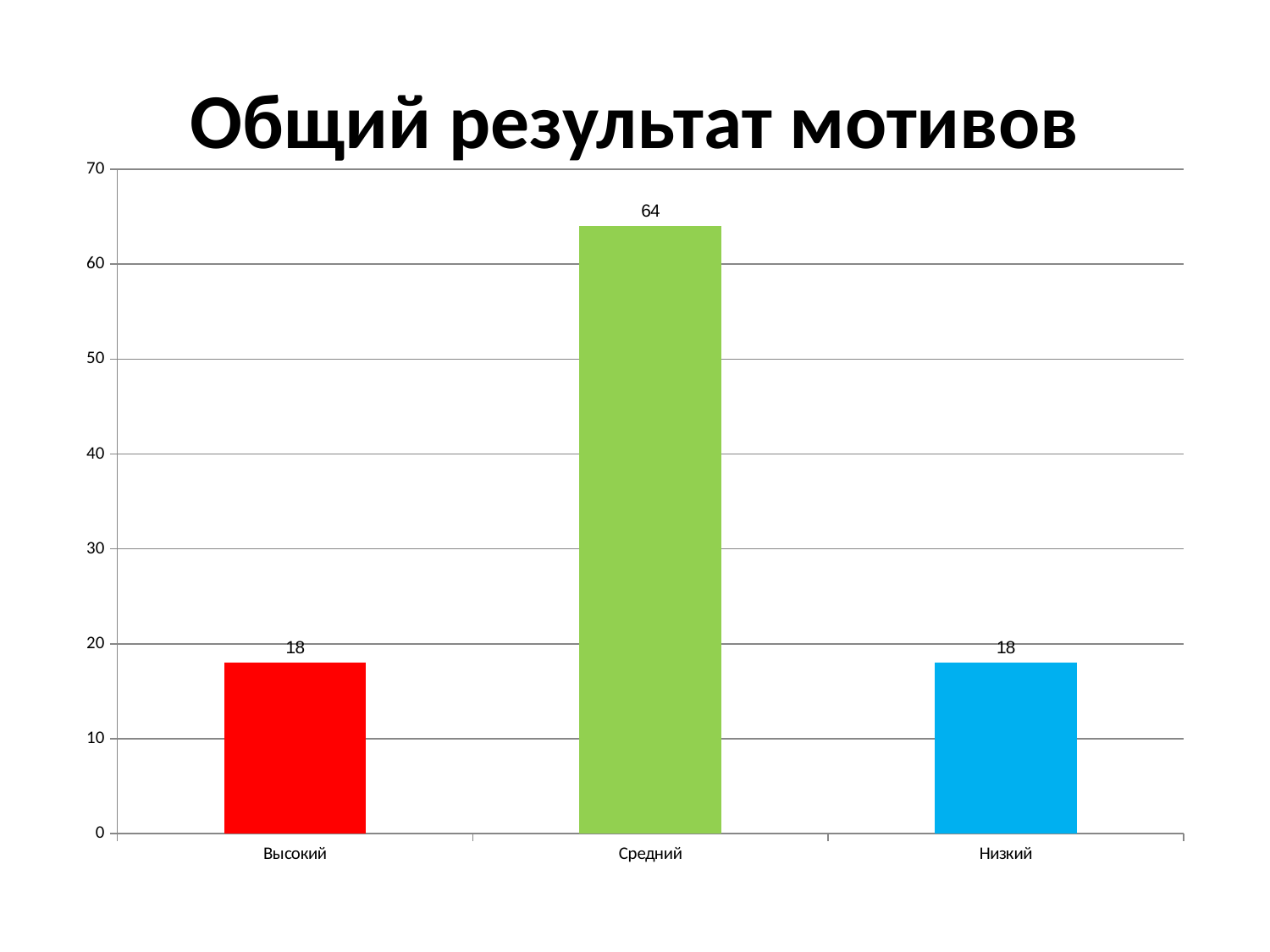
Which is larger, the value for Средний or the value for Низкий? Средний What is the difference between the values for Средний and Высокий? 46 What is the title of the chart? Общий результат мотивов What is the value for Низкий? 18 What kind of chart is shown on the slide? bar chart How many categories are shown on the chart? 3 What colour is the bar for Средний? green What is the value for Средний? 64 Is the value for Высокий greater or less than 20? less What is the value for Высокий? 18 Is the value for Средний greater or less than 60? greater Which category has the highest value? Средний